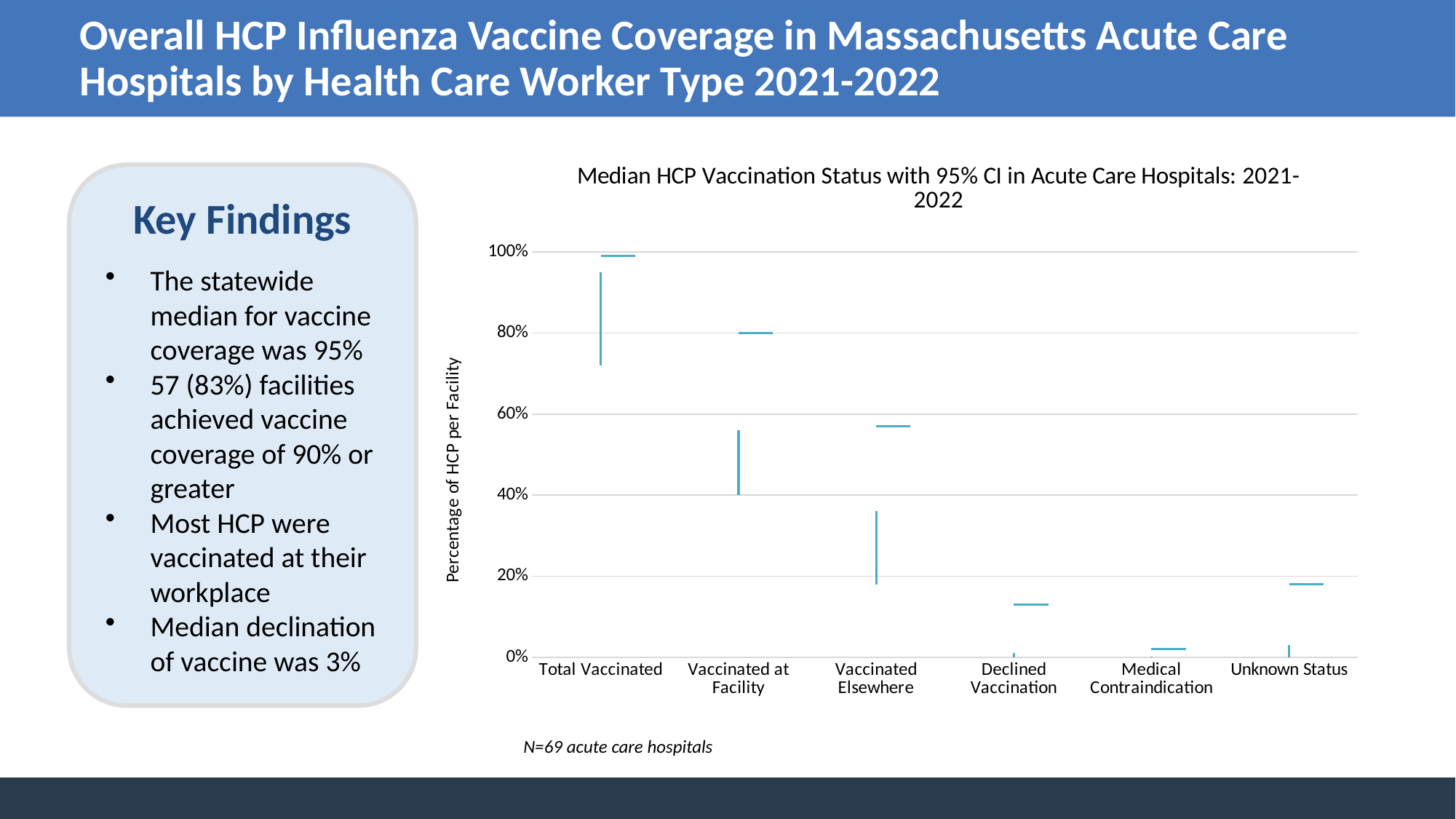
Which category has the highest median value in the chart? Total Vaccinated What is the label of the chart's y axis? Percentage of HCP per Facility How many categories are shown on the x axis of the chart? 6 Which has a higher median value, Total Vaccinated or Declined Vaccination? Total Vaccinated Is the median value for Declined Vaccination greater or less than 20%? less Which category has the lowest median value in the chart? Medical Contraindication Is the median value for Medical Contraindication greater or less than 20%? less Which has a higher median value, Vaccinated at Facility or Vaccinated Elsewhere? Vaccinated at Facility Is the median value for Total Vaccinated greater or less than 80%? greater What is the title of the chart? Median HCP Vaccination Status with 95% CI in Acute Care Hospitals: 2021-2022